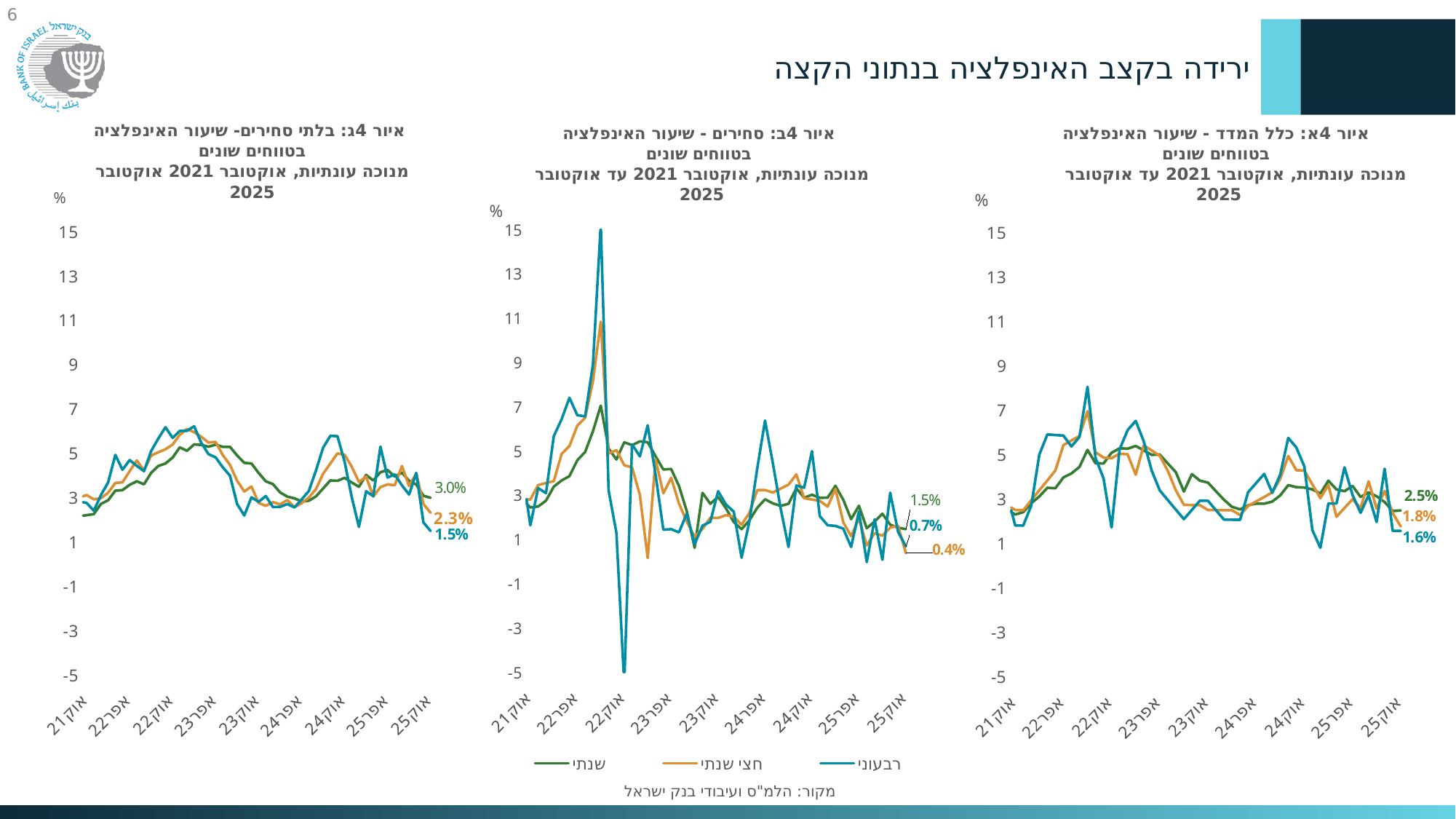
In the right-hand chart (איור 4א: כלל המדד), which series has the highest final labelled value? שנתי In the right-hand chart (איור 4א: כלל המדד), what is the final labelled value of the annual (שנתי) series? 2.5% In the left-hand chart (איור 4ג: בלתי סחירים), what is the difference between the final labelled annual value and the final labelled quarterly value? 1.5% In the middle chart (איור 4ב: סחירים), what is the final labelled value of the annual (שנתי) series? 1.5% What type of chart is used in all three panels on the slide? Line chart In the right-hand chart (איור 4א: כלל המדד), what is the final labelled value of the quarterly (רבעוני) series? 1.6% In the middle chart (איור 4ב: סחירים), what is the final labelled value of the semi-annual (חצי שנתי) series? 0.4% How many series does the shared legend list? 3 In the left-hand chart (איור 4ג: בלתי סחירים), what is the final labelled value of the semi-annual (חצי שנתי) series? 2.3% In the middle chart (איור 4ב: סחירים), is the final labelled quarterly (רבעוני) value larger or smaller than the final labelled annual (שנתי) value? smaller In the middle chart (איור 4ב: סחירים), which series has the lowest final labelled value? חצי שנתי In the middle chart (איור 4ב: סחירים), is the peak of the quarterly (רבעוני) series in 2022 greater or less than 13? greater